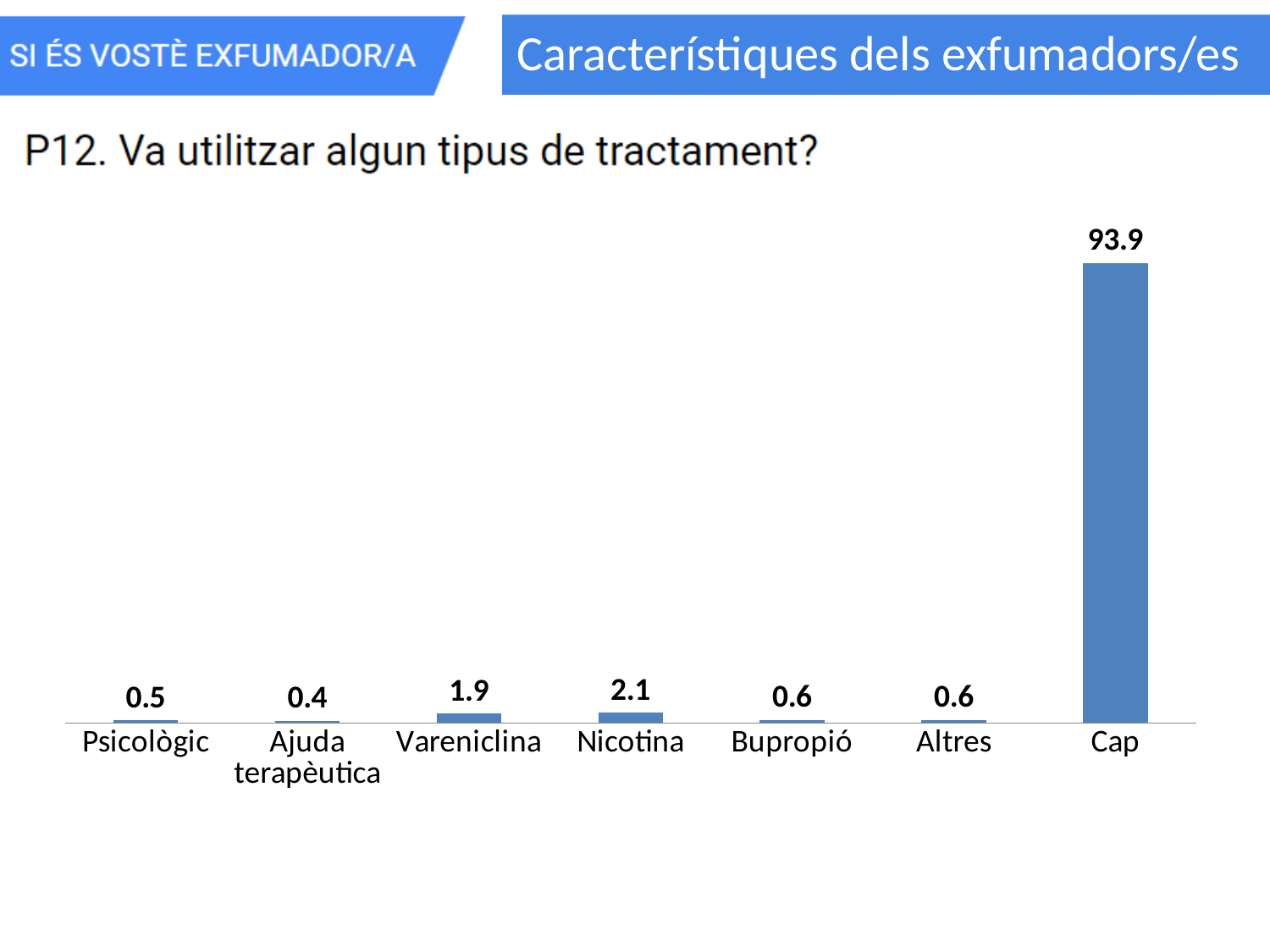
What is the value for Ajuda terapèutica? 0.4 What question is the chart about, as written above it? P12. Va utilitzar algun tipus de tractament? Which category has the lowest value? Ajuda terapèutica What kind of chart is shown on the slide? Bar chart What is the value for Vareniclina? 1.9 Which category has the highest value? Cap How many categories are shown on the x axis? 7 Which is larger, the value for Vareniclina or the value for Psicològic? Vareniclina What is the value for Cap? 93.9 What is the difference between the values for Cap and Nicotina? 91.8 What is the value for Nicotina? 2.1 What is the difference between the values for Nicotina and Vareniclina? 0.2